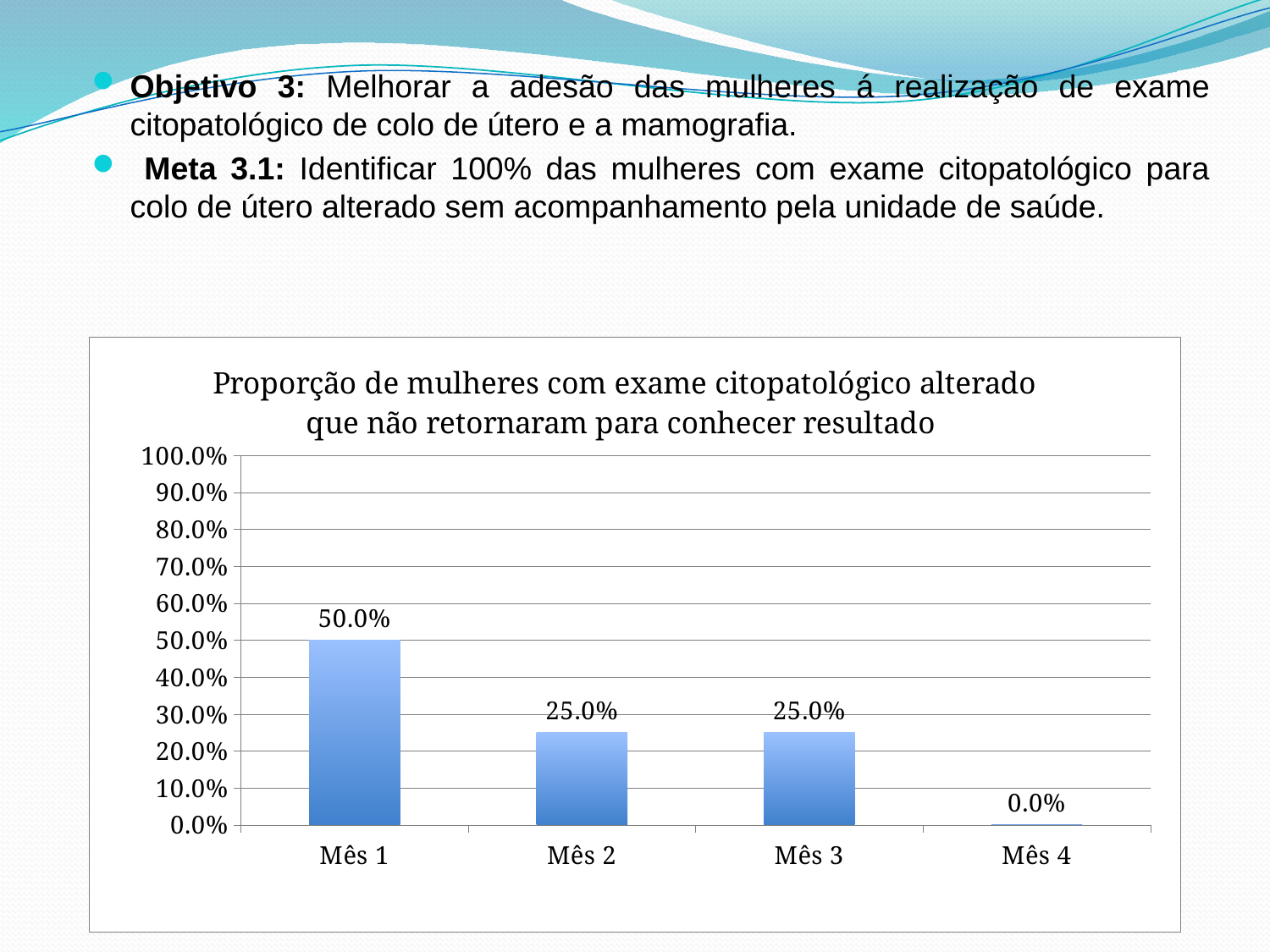
Which is larger, the value for Mês 1 or the value for Mês 3? Mês 1 What kind of chart is shown on the slide? bar chart How many months are shown on the x axis? 4 Do the values rise or fall from Mês 1 to Mês 4? fall What is the value for Mês 4? 0.0% Which month has the highest value? Mês 1 What is the difference between the values for Mês 3 and Mês 4? 25.0% Is the value for Mês 1 greater or less than 40.0%? greater Which month has the lowest value? Mês 4 What is the value for Mês 1? 50.0% What is the difference between the values for Mês 1 and Mês 2? 25.0% What is the value for Mês 2? 25.0%